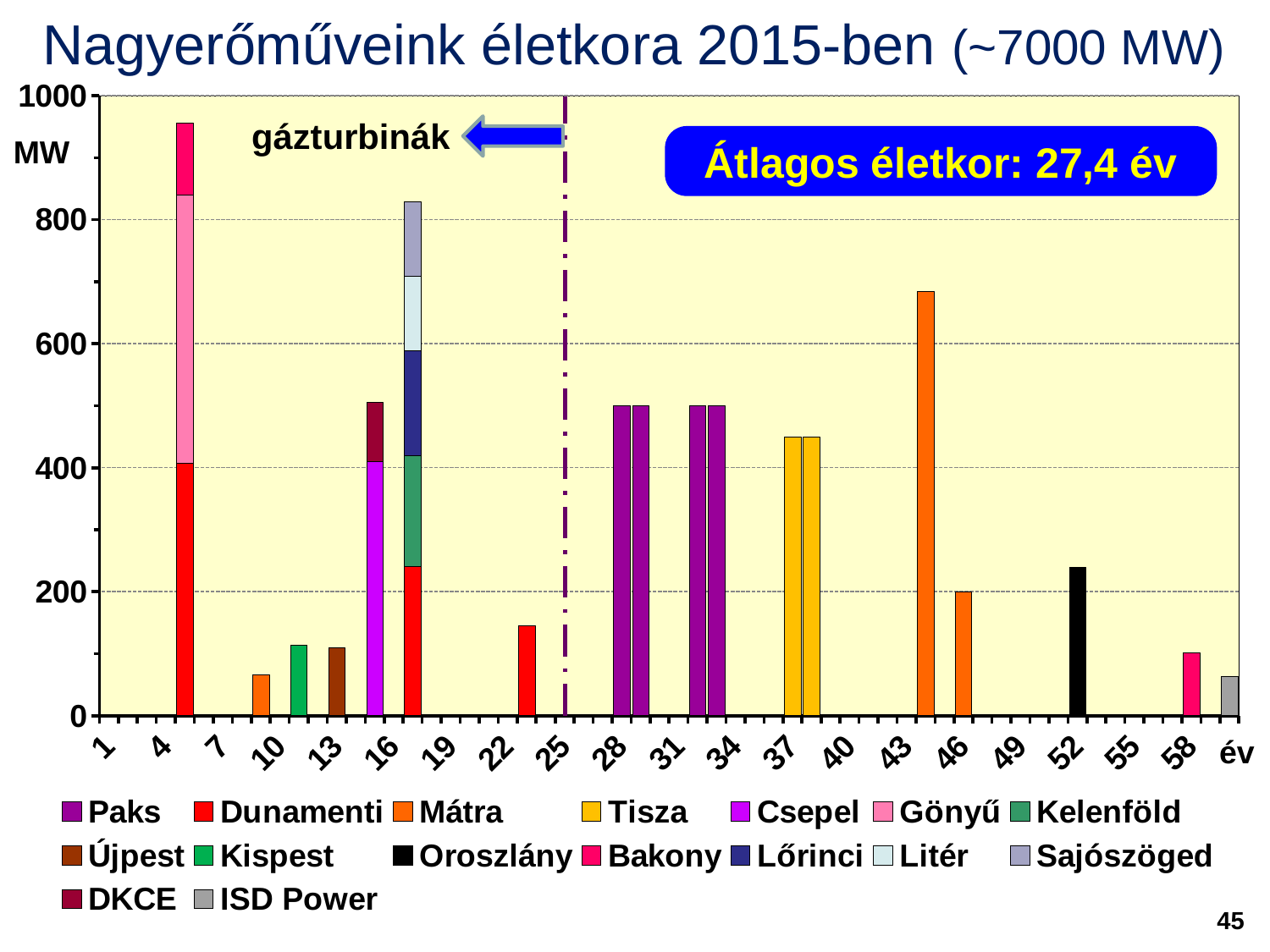
Is the total of the stacked bar at around 5 years (Dunamenti, Gönyű, Bakony) greater or less than 800? greater Is the value of the Mátra bar at around 44 years greater or less than 600? greater Which is larger: the Mátra bar at around 44 years or the Mátra bar at around 46 years? the Mátra bar at around 44 years Is the value of the Kispest bar at around 11 years greater or less than 200? less What is the average age stated in the box on the chart? 27,4 év How many series does the legend list? 16 What unit is shown on the vertical axis of the chart? MW What kind of chart is shown on the slide? stacked bar chart